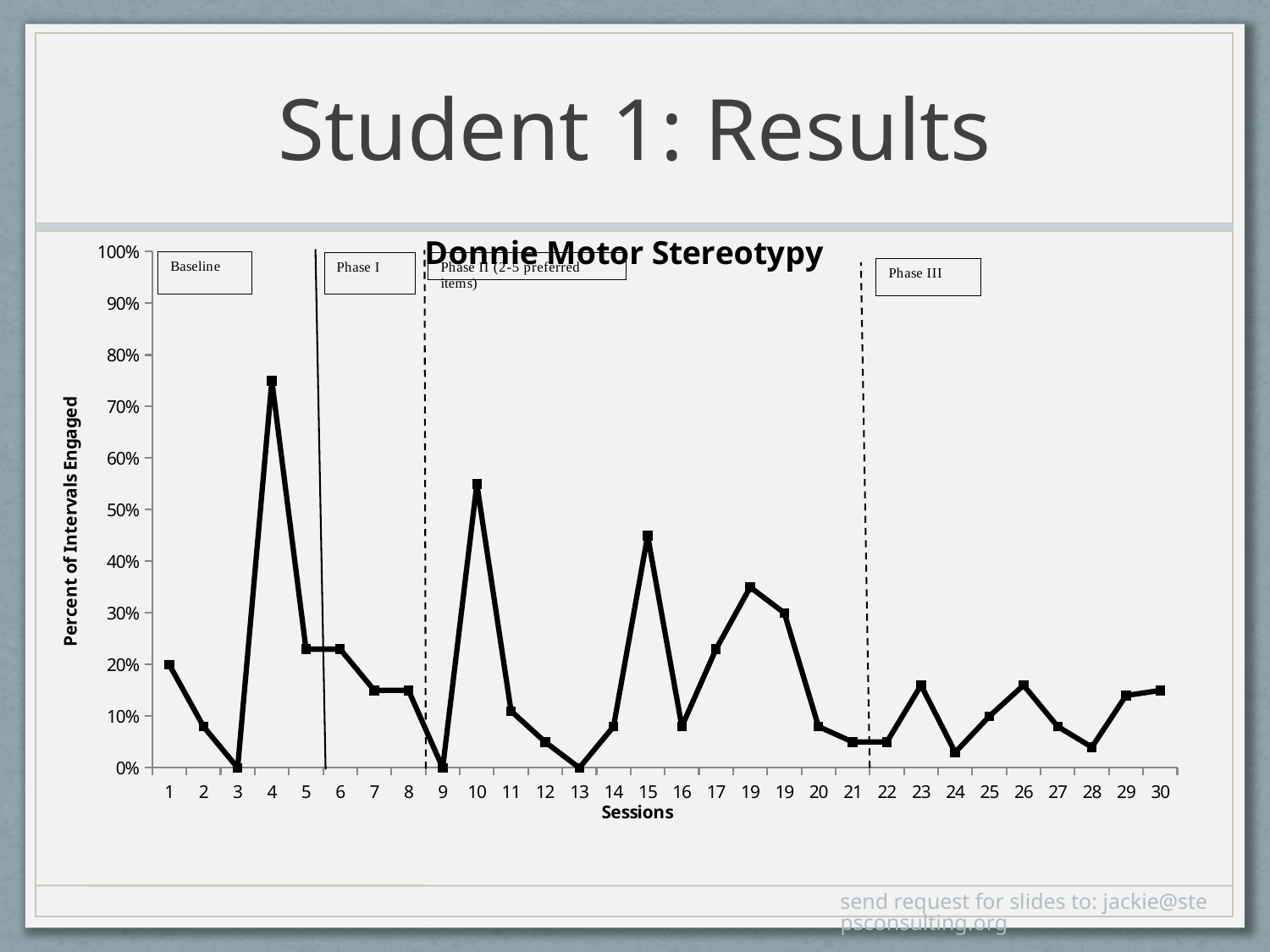
Which is larger, the value at session 4 or the value at session 10? session 4 What is the label of the vertical axis? Percent of Intervals Engaged What kind of chart is shown on the slide? line chart What is the percent of intervals engaged at session 3? 0% What is the title of the chart? Donnie Motor Stereotypy Which session has the highest percent of intervals engaged? 4 Is the value at session 24 greater or less than 10%? less What is the percent of intervals engaged at session 1? 20% Is the value at session 10 greater or less than 50%? greater Is the value at session 4 greater or less than 70%? greater How many sessions are labelled along the x axis? 30 Do the values rise or fall from session 1 to session 3? fall